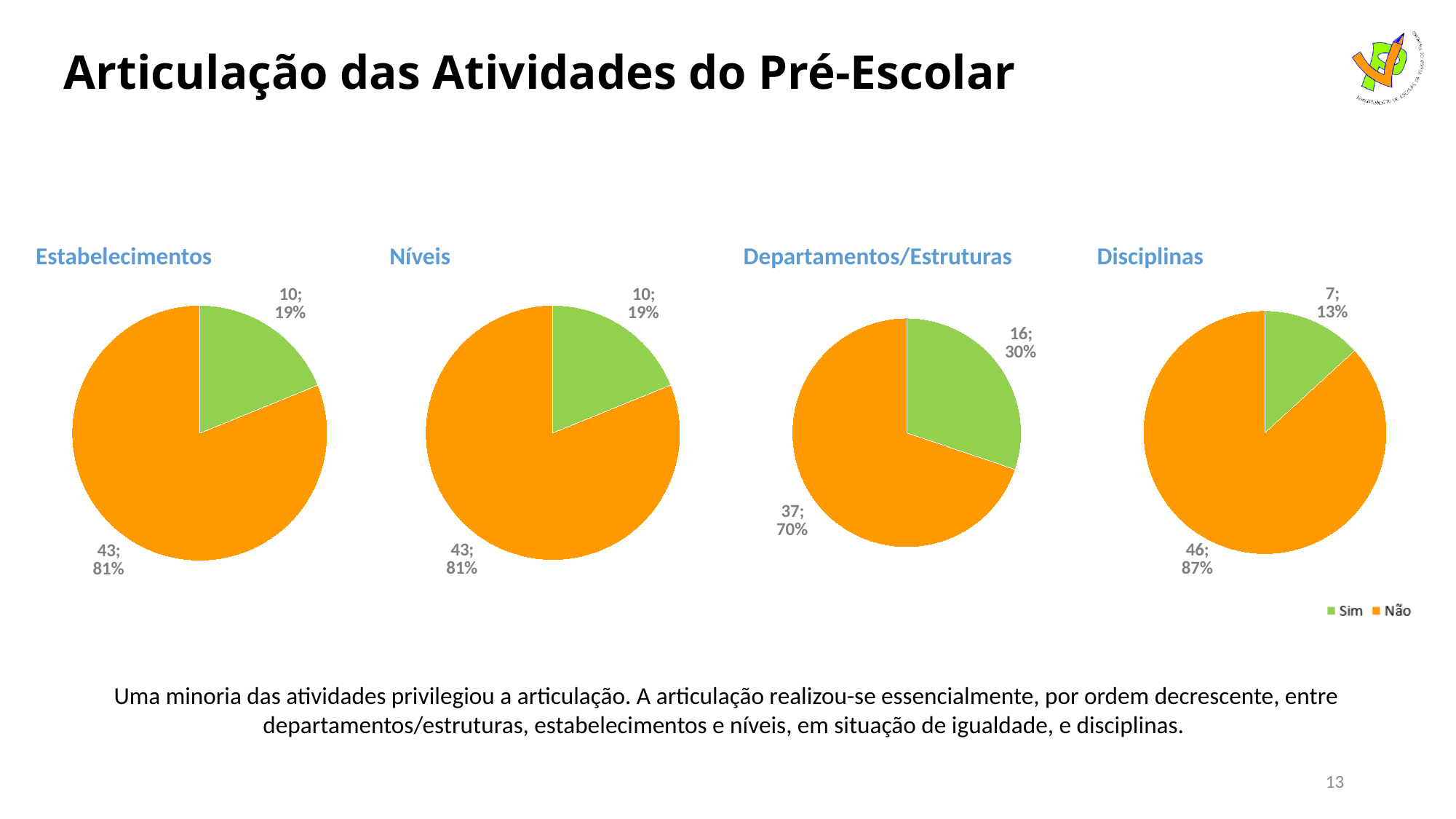
What kind of chart is used for Disciplinas? Pie chart In the Departamentos/Estruturas pie chart, which slice is larger, Sim or Não? Não How many series does the legend list? 2 In the Departamentos/Estruturas pie chart, what share of the pie does Não represent? 70% In the Disciplinas pie chart, what is the difference between the Não count and the Sim count? 39 In the Estabelecimentos pie chart, what is the total of the two slices? 53 In the Níveis pie chart, what is the value for Não? 43; 81% In the Disciplinas pie chart, what is the value for Não? 46; 87% How many slices does the Níveis pie chart have? 2 In the Departamentos/Estruturas pie chart, what is the value for Sim? 16; 30% In the Disciplinas pie chart, what share of the pie does Sim represent? 13% In the Estabelecimentos pie chart, what is the value for Sim? 10; 19%